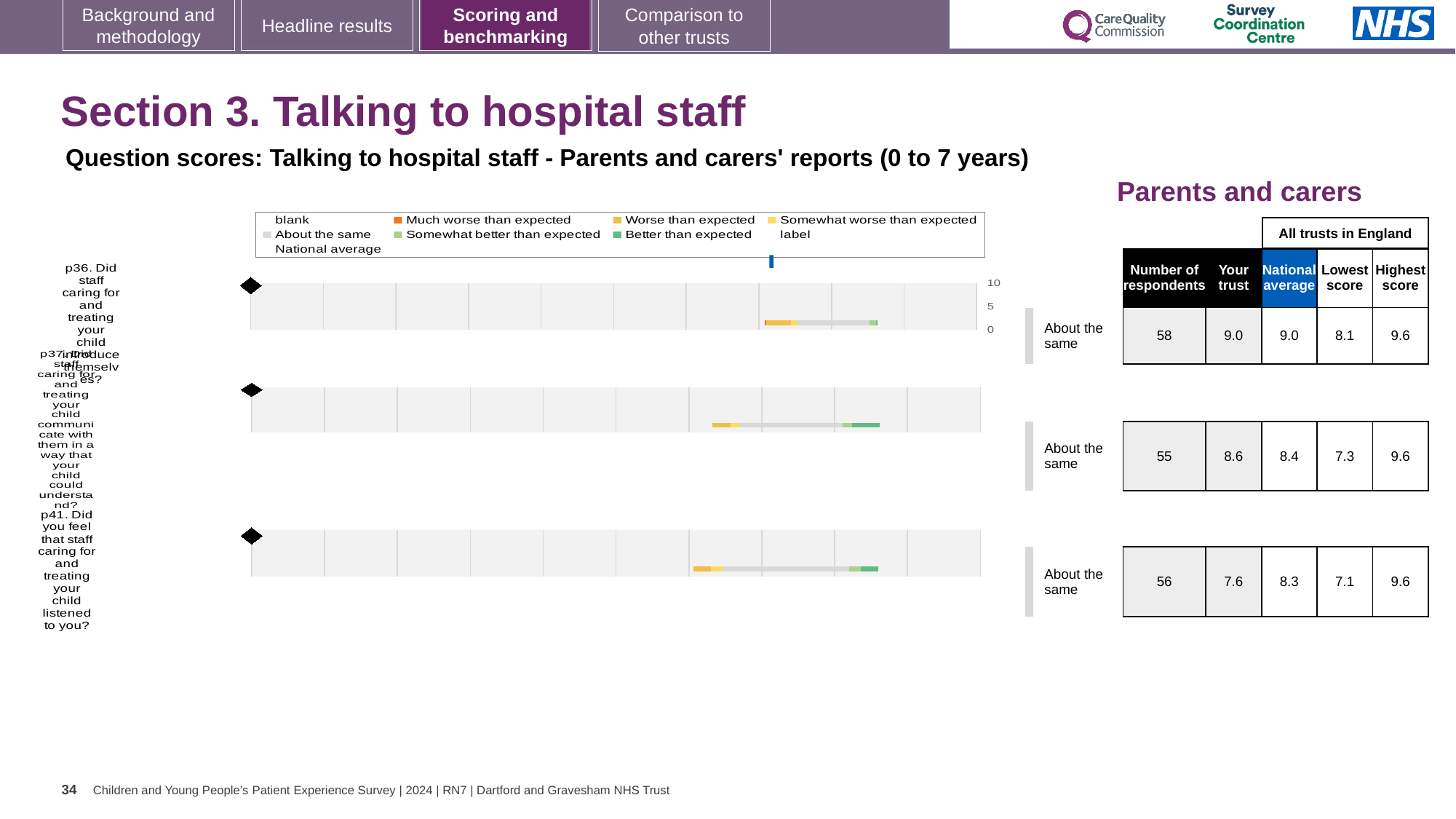
What kind of chart is used to show the question scores on this slide? bar chart Which has the higher 'Your trust' score, p36 or p37? p36 For the p36 chart (staff introducing themselves), what is the number of respondents shown in the table? 58 What is the heading printed above the table to the right of the charts? Parents and carers For the p36 chart, what is the highest score among all trusts in England? 9.6 For the p41 chart, what is the lowest score among all trusts in England? 7.1 For the p41 chart, what is the difference between the national average and the 'Your trust' score? 0.7 Which of the three questions has the lowest 'Your trust' score? p41 How many survey questions (p36, p37, p41) are plotted on the slide? 3 What benchmark category is shown next to the p37 chart? About the same For the p41 chart (staff listened to you), what is the 'Your trust' score shown in the table? 7.6 For the p37 chart (staff communicating in a way your child could understand), what is the national average shown in the table? 8.4